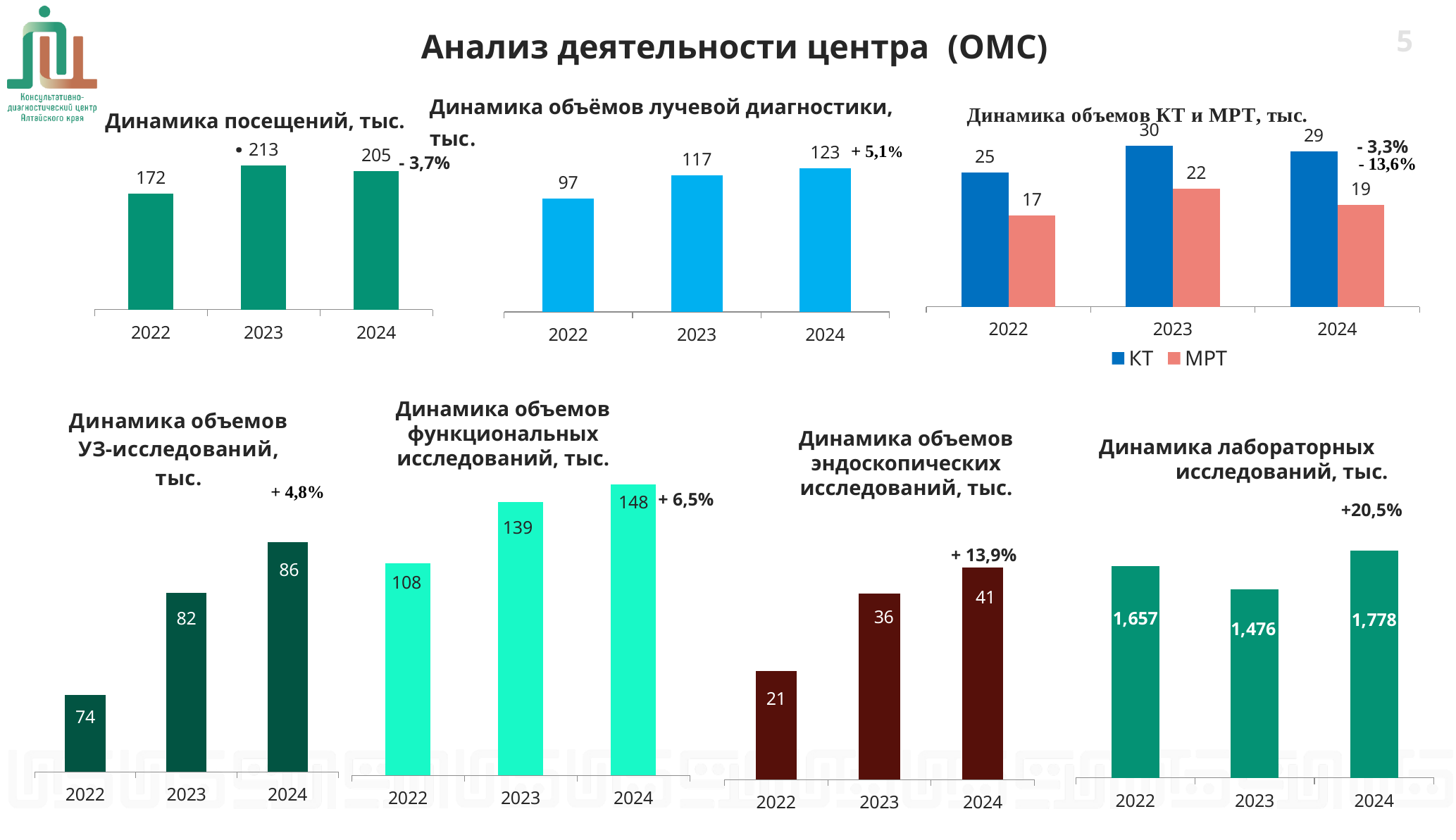
How many series does the legend list in the chart 'Динамика объемов КТ и МРТ, тыс.'? 2 In the chart 'Динамика объемов эндоскопических исследований, тыс.', what is the difference between the 2023 and 2022 values? 15 In the chart 'Динамика объемов УЗ-исследований, тыс.', which year has the lowest value? 2022 In the chart 'Динамика объемов функциональных исследований, тыс.', what is the value for 2024? 148 In the chart 'Динамика посещений, тыс.', what is the value for 2023? 213 In the chart 'Динамика объёмов лучевой диагностики, тыс.', what is the difference between the 2024 and 2022 values? 26 In the chart 'Динамика посещений, тыс.', which year has the highest value? 2023 In the chart 'Динамика объёмов лучевой диагностики, тыс.', do the values rise or fall from 2022 to 2024? rise In the chart 'Динамика объемов КТ и МРТ, тыс.', what is the МРТ value for 2023? 22 In the chart 'Динамика лабораторных исследований, тыс.', what is the value for 2023? 1,476 What kind of chart is 'Динамика лабораторных исследований, тыс.'? bar chart In the chart 'Динамика объемов КТ и МРТ, тыс.', which is larger in 2024, КТ or МРТ? КТ